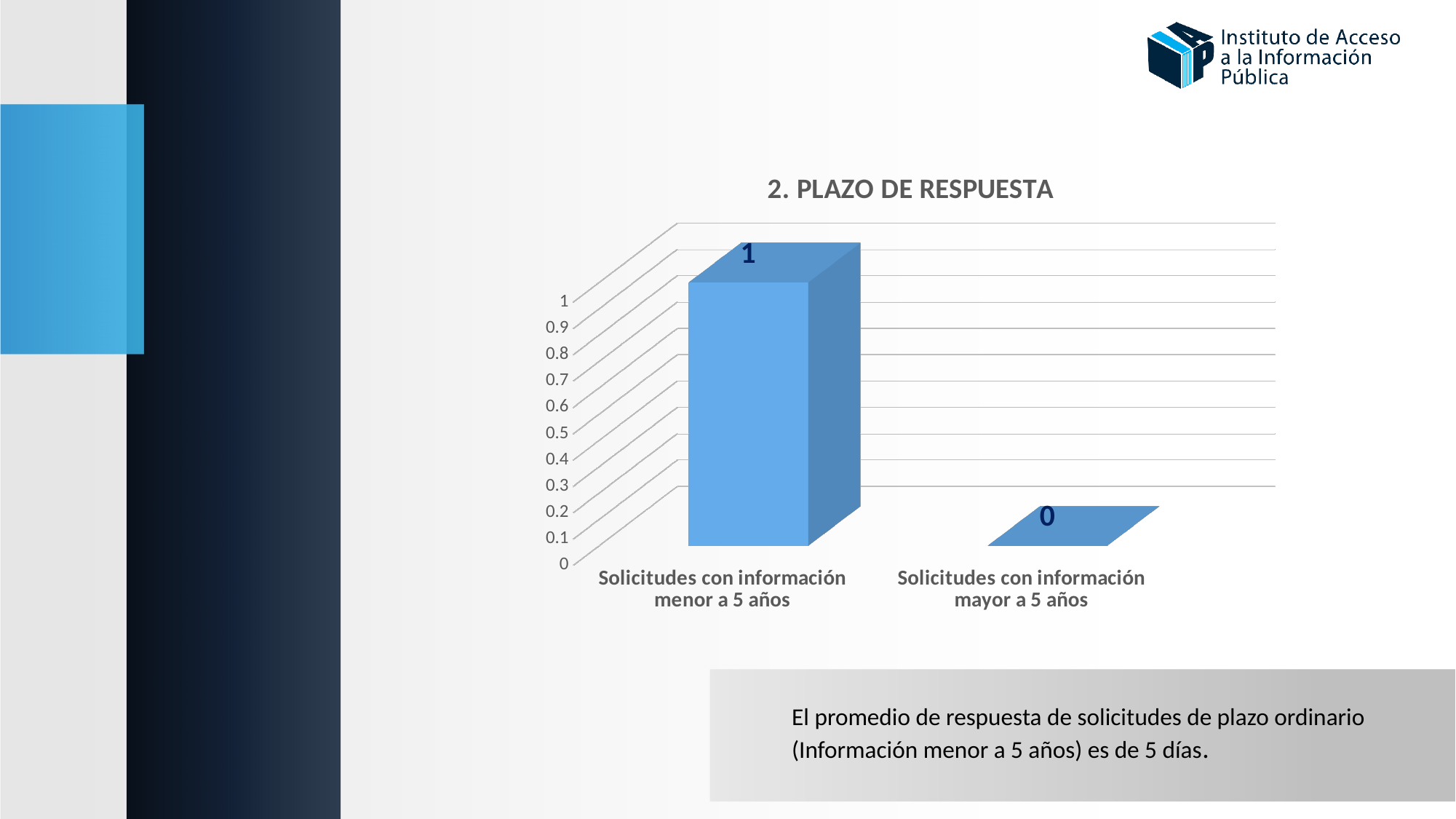
Do the values rise or fall from left to right along the x axis? fall Which category has the highest value? Solicitudes con información menor a 5 años What is the title of the chart? 2. PLAZO DE RESPUESTA What is the value for 'Solicitudes con información mayor a 5 años'? 0 What is the maximum value shown on the vertical axis? 1 What kind of chart is shown on the slide? bar chart How many categories are shown on the x axis? 2 What is the value for 'Solicitudes con información menor a 5 años'? 1 Is the value for 'Solicitudes con información menor a 5 años' greater or less than 0.5? greater Which is larger: the value for 'Solicitudes con información menor a 5 años' or for 'Solicitudes con información mayor a 5 años'? Solicitudes con información menor a 5 años Which category has the lowest value? Solicitudes con información mayor a 5 años What is the difference between the values for 'Solicitudes con información menor a 5 años' and 'Solicitudes con información mayor a 5 años'? 1